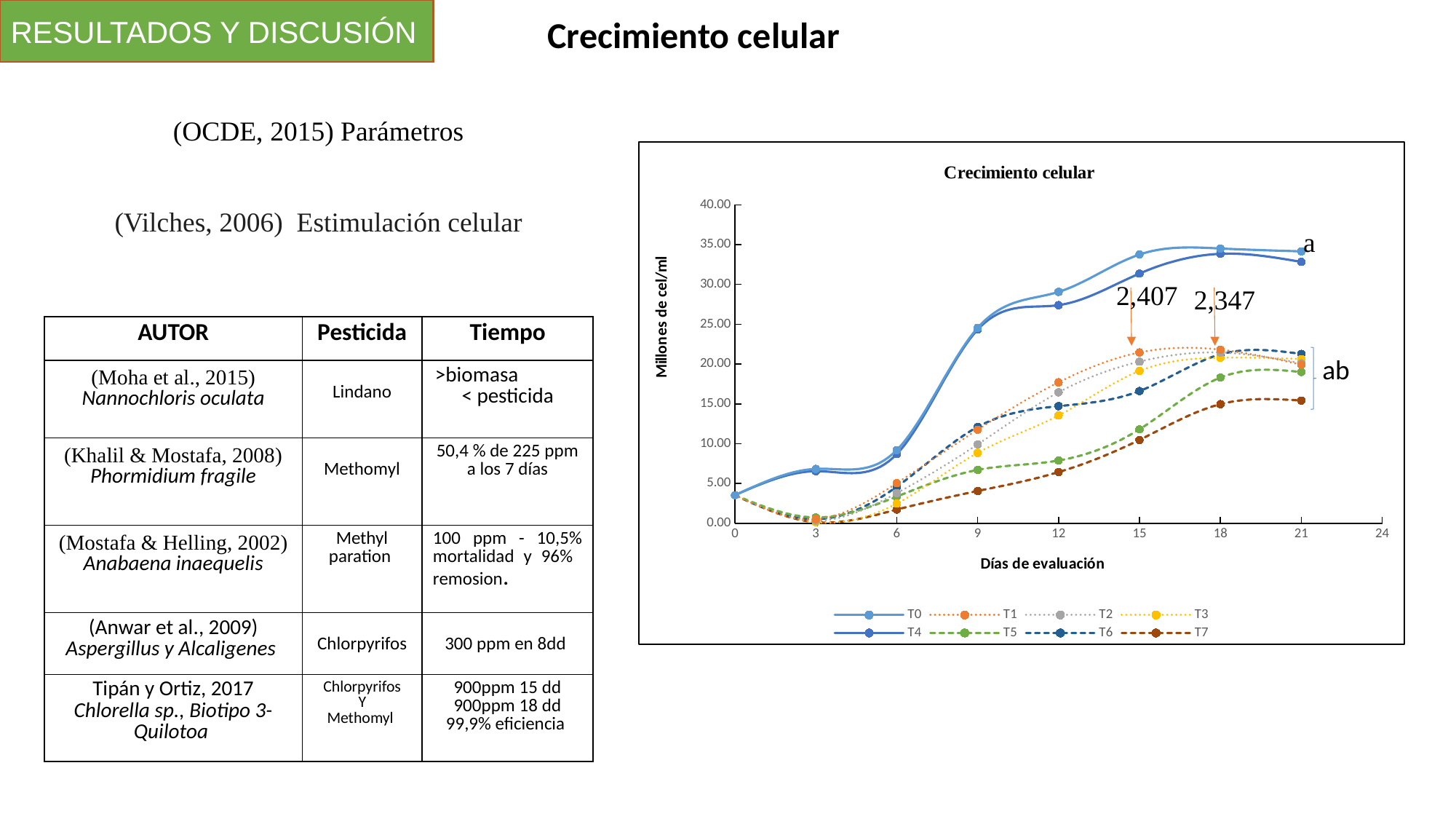
Is the value for T5 at day 12 greater or less than 10? less Is the value for T7 at day 21 greater or less than 20? less How many evaluation days (data points) are plotted for each series in the chart? 8 Is the value for T0 at day 9 greater or less than 20? greater What is the label of the vertical axis of the chart? Millones de cel/ml How many series does the legend of the chart list? 8 At day 12, which is larger, the value for T1 or the value for T5? T1 Which series has the lowest value at day 21? T7 What kind of chart is shown on the slide? Line chart Which series has the highest value at day 15? T0 What is the title of the chart? Crecimiento celular